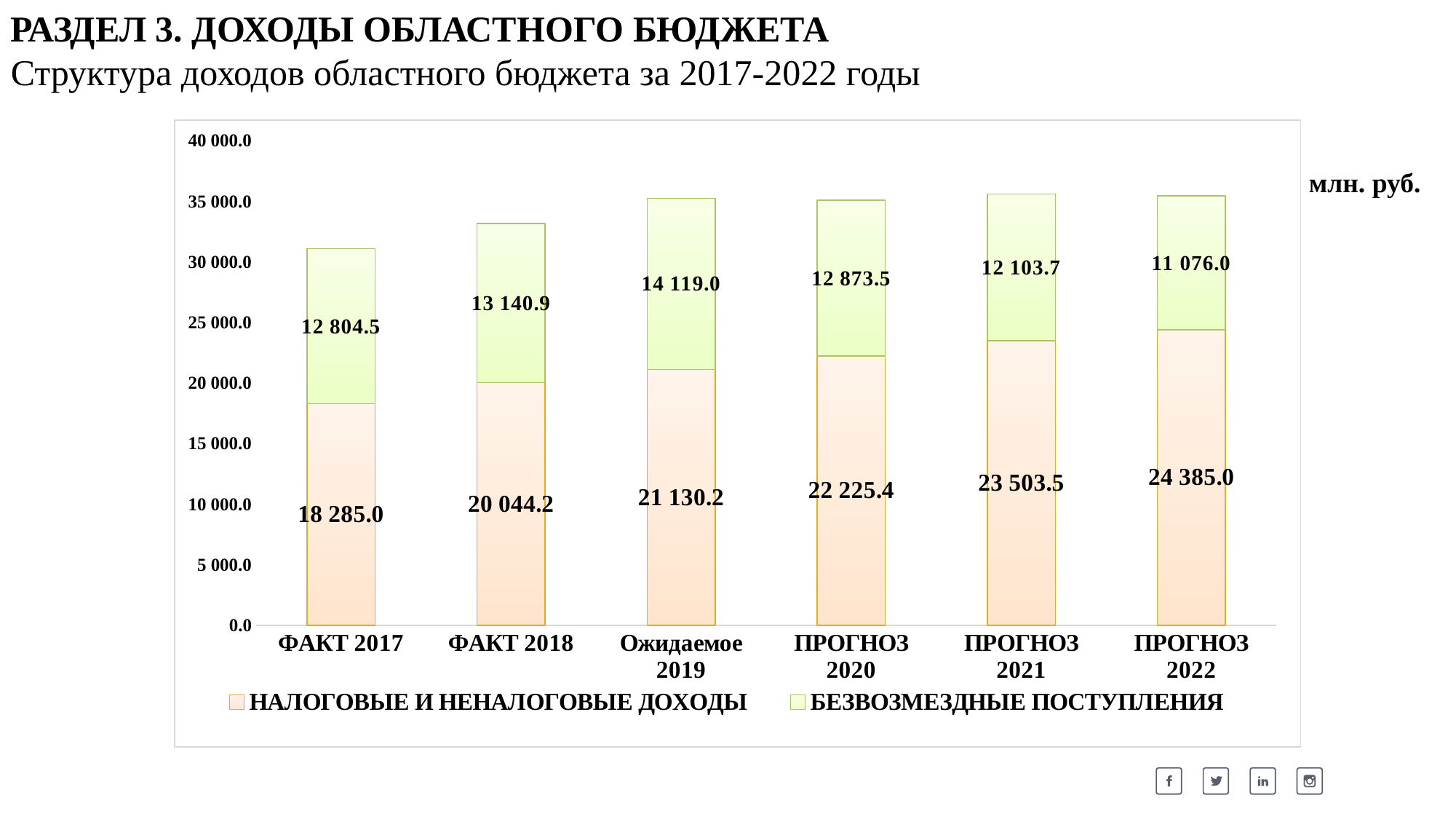
What is the difference between НАЛОГОВЫЕ И НЕНАЛОГОВЫЕ ДОХОДЫ for ПРОГНОЗ 2022 and ФАКТ 2017? 6 100.0 What is the total of the stacked bar for ФАКТ 2017? 31 089.5 Which is larger: БЕЗВОЗМЕЗДНЫЕ ПОСТУПЛЕНИЯ for ФАКТ 2018 or for ПРОГНОЗ 2022? ФАКТ 2018 What is the value of БЕЗВОЗМЕЗДНЫЕ ПОСТУПЛЕНИЯ for ПРОГНОЗ 2020? 12 873.5 Do the values of НАЛОГОВЫЕ И НЕНАЛОГОВЫЕ ДОХОДЫ rise or fall from ФАКТ 2017 to ПРОГНОЗ 2022? Rise What unit is indicated next to the chart? млн. руб. What is the value of НАЛОГОВЫЕ И НЕНАЛОГОВЫЕ ДОХОДЫ for ФАКТ 2017? 18 285.0 How many categories are shown on the x axis? 6 Which category has the highest value for БЕЗВОЗМЕЗДНЫЕ ПОСТУПЛЕНИЯ? Ожидаемое 2019 Which category has the lowest value for НАЛОГОВЫЕ И НЕНАЛОГОВЫЕ ДОХОДЫ? ФАКТ 2017 How many series does the legend list? 2 What type of chart is shown on the slide? Stacked bar chart